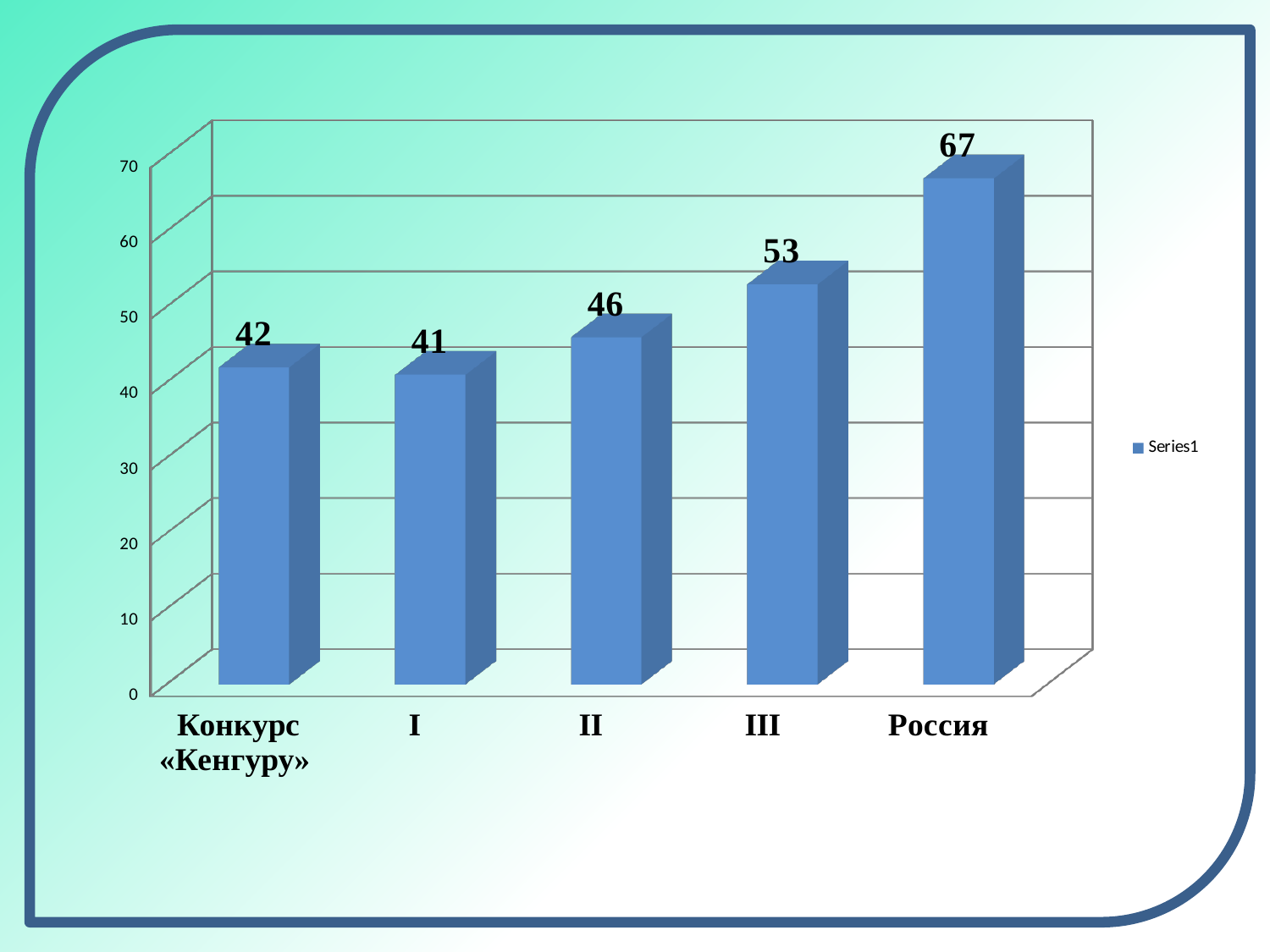
How many categories are shown on the x axis? 5 What is the difference between the values for Россия and III? 14 Which category has the lowest value? I Which category has the highest value? Россия What series name does the legend list? Series1 Which is larger, the value for II or the value for III? III What is the value for category III? 53 What is the value for Конкурс «Кенгуру»? 42 What is the value for category II? 46 What is the value for Россия? 67 What is the value for category I? 41 What kind of chart is shown on the slide? Bar chart